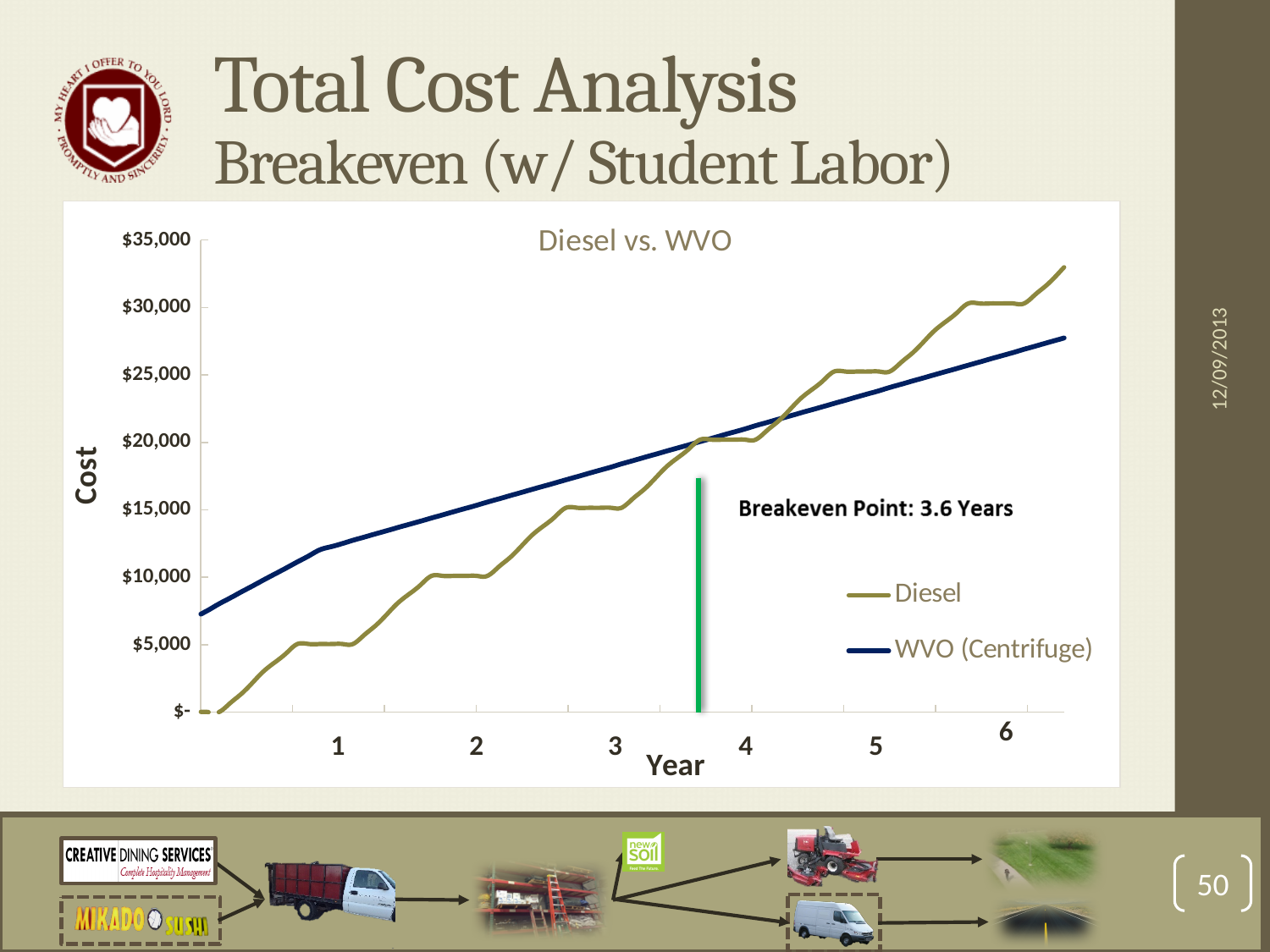
How many series does the chart legend list? 2 Does the Diesel cost rise or fall as the years increase? rise What is the label of the vertical axis? Cost What is the title of the chart? Diesel vs. WVO Is the cost for WVO (Centrifuge) at year 1 greater or less than $10,000? greater Which series has the higher cost at year 6, Diesel or WVO (Centrifuge)? Diesel Is the cost for WVO (Centrifuge) at year 6 greater or less than $30,000? less What breakeven point is annotated on the chart? 3.6 Years Which series is drawn in dark blue? WVO (Centrifuge) Which series starts at the higher cost at the left edge of the chart? WVO (Centrifuge) Which series has the higher cost at year 2, Diesel or WVO (Centrifuge)? WVO (Centrifuge) What kind of chart is shown on the slide? line chart